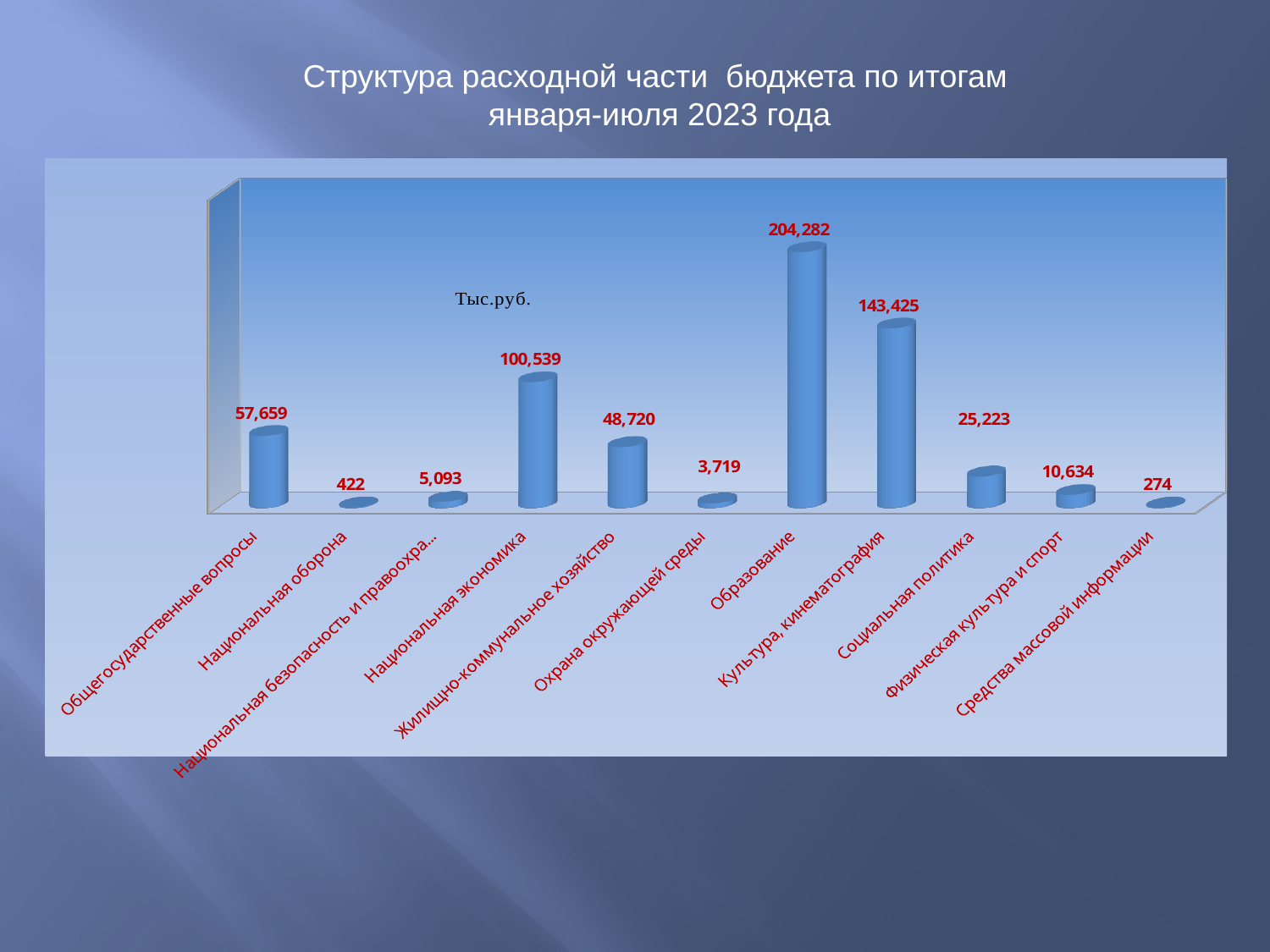
Which category has the highest value? Образование Which is larger, the value for Национальная оборона or the value for Охрана окружающей среды? Охрана окружающей среды What kind of chart is shown on the slide? Bar chart Which category has the lowest value? Средства массовой информации How many categories are shown in the chart? 11 What is the value for Физическая культура и спорт? 10,634 What is the value for Образование? 204,282 What unit of measurement is indicated on the chart? Тыс.руб. What is the difference between the values for Общегосударственные вопросы and Социальная политика? 32,436 What is the value for Национальная экономика? 100,539 What is the difference between the values for Образование and Культура, кинематография? 60,857 What is the value for Жилищно-коммунальное хозяйство? 48,720